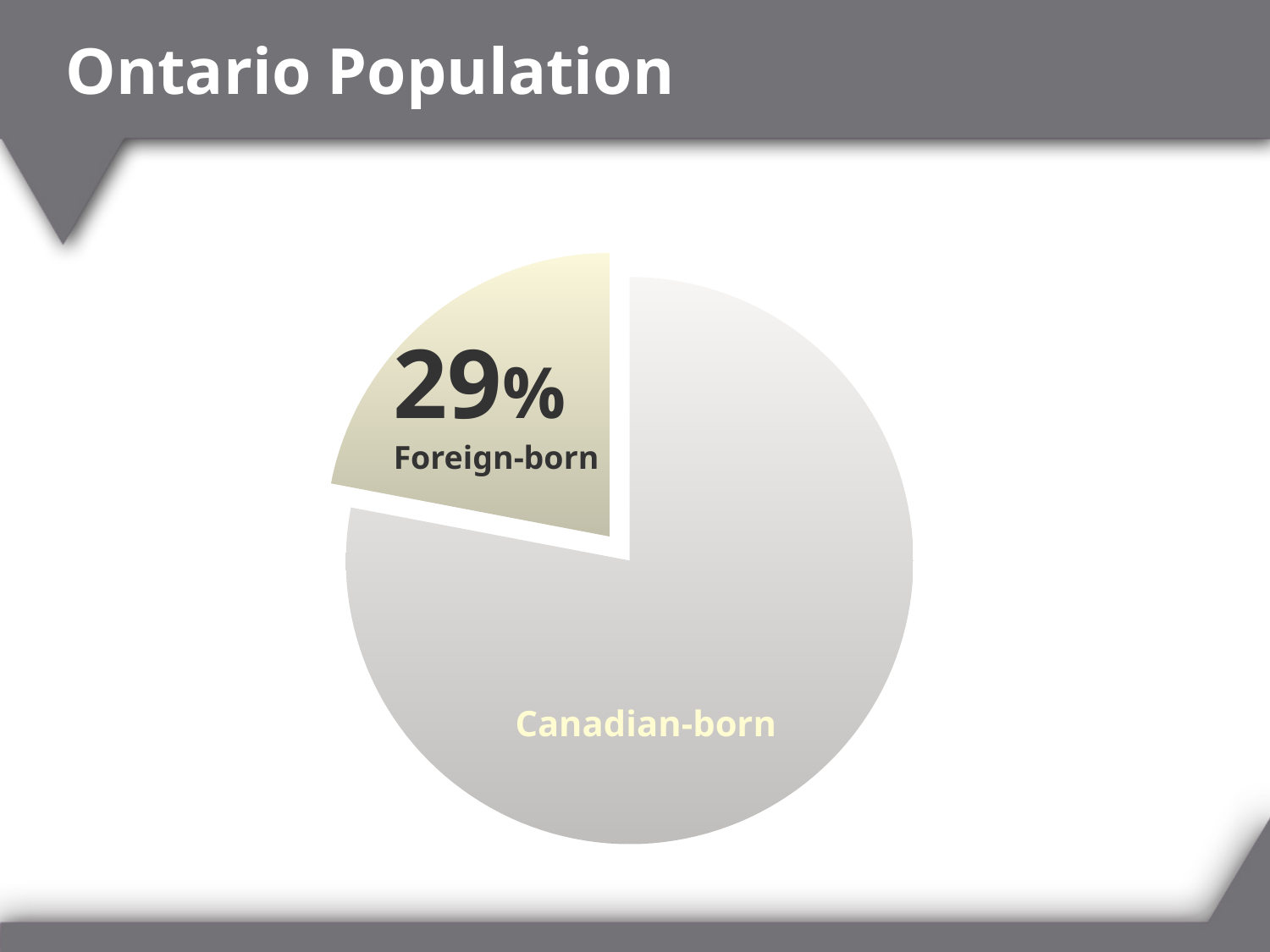
Which slice of the pie chart is pulled out (exploded) from the rest of the pie? Foreign-born Which slice of the pie chart is the largest? Canadian-born Which slice of the pie chart is the smallest? Foreign-born What share of the Ontario population is Foreign-born according to the pie chart? 29% What kind of chart is shown on the slide? pie chart How many slices does the pie chart have? 2 What is the title of the slide containing the pie chart? Ontario Population Which is larger in the pie chart, the Canadian-born slice or the Foreign-born slice? Canadian-born